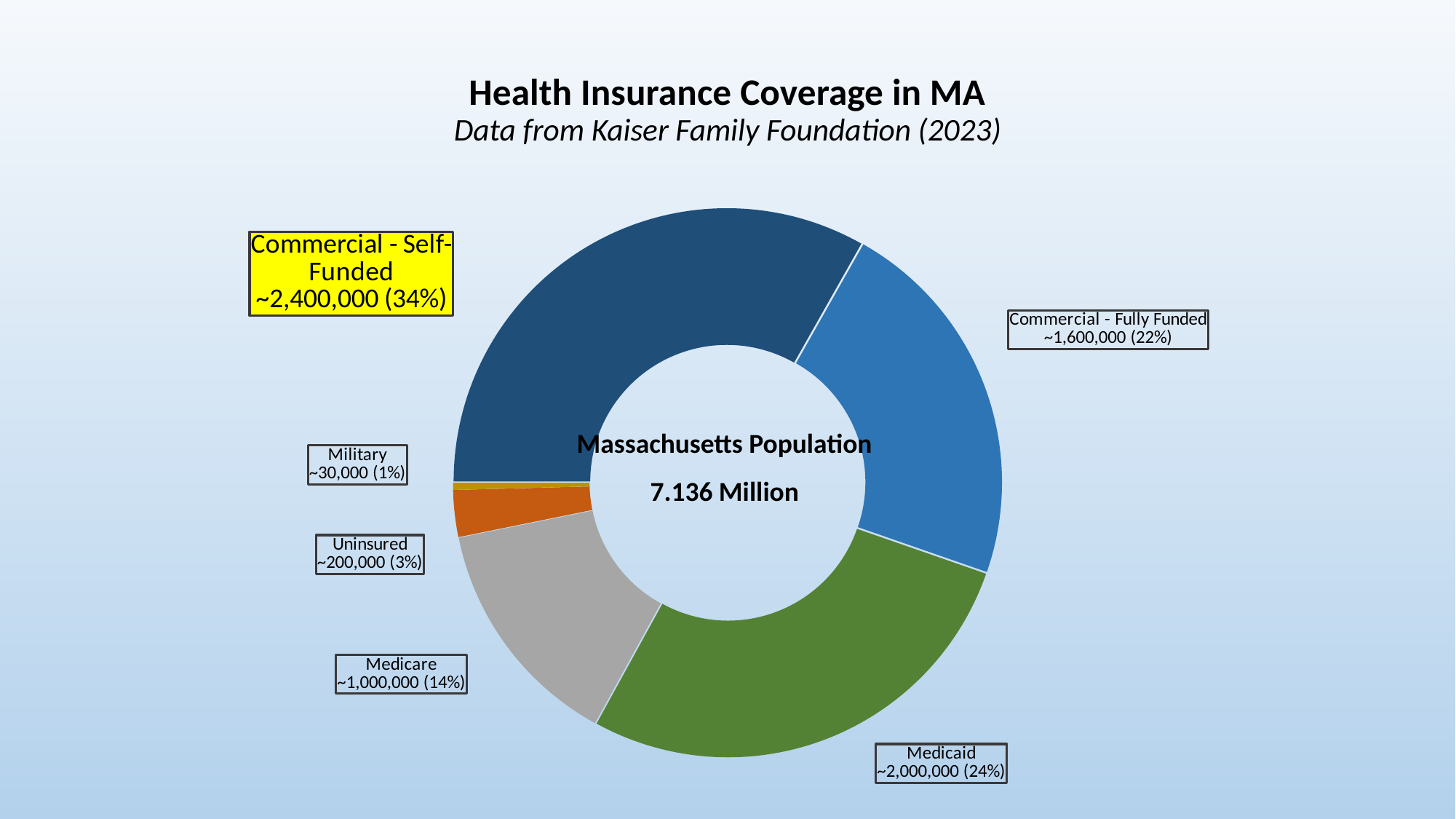
What share of the Massachusetts population is covered by Commercial - Self-Funded insurance? 34% What share of the population is covered by Medicaid? 24% What is the title of the chart? Health Insurance Coverage in MA By how many percentage points does the Commercial - Self-Funded share exceed the Commercial - Fully Funded share? 12 percentage points What kind of chart is shown on the slide? Doughnut (pie) chart How many coverage categories are shown in the chart? 6 What percentage is shown for Commercial - Fully Funded? 22% Which is larger, the share for Medicaid or the share for Medicare? Medicaid What percentage is shown for Medicare? 14% Which category has the smallest share of the chart? Military What percentage of the population is Uninsured? 3% Which category has the largest share of the chart? Commercial - Self-Funded